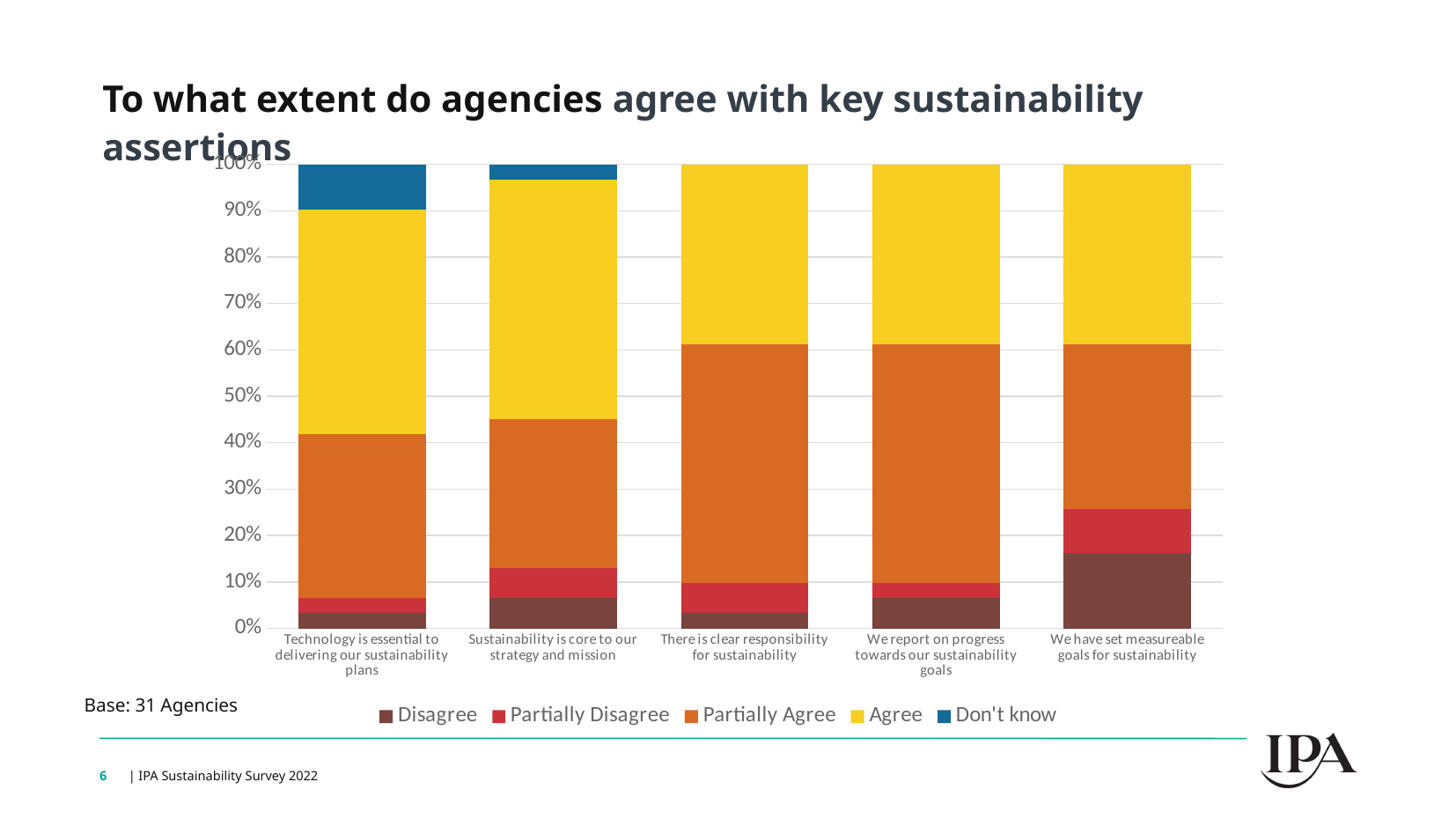
Which has the larger Don't know share: 'Technology is essential to delivering our sustainability plans' or 'Sustainability is core to our strategy and mission'? Technology is essential to delivering our sustainability plans Is the Agree share for 'Technology is essential to delivering our sustainability plans' greater or less than 40%? greater What kind of chart is shown on the slide? Stacked bar chart Is the Disagree share for 'Technology is essential to delivering our sustainability plans' greater or less than 10%? less Which assertion has the largest Disagree segment? We have set measureable goals for sustainability How many assertions (categories) are shown along the x axis? 5 Which series is shown in yellow in the legend? Agree What is the total height of the stacked bar for 'There is clear responsibility for sustainability'? 100% Which has the larger Disagree share: 'We have set measureable goals for sustainability' or 'Technology is essential to delivering our sustainability plans'? We have set measureable goals for sustainability How many series does the legend list? 5 Is the Disagree share for 'We have set measureable goals for sustainability' greater or less than 10%? greater What is the base (number of agencies) stated on the slide? 31 Agencies